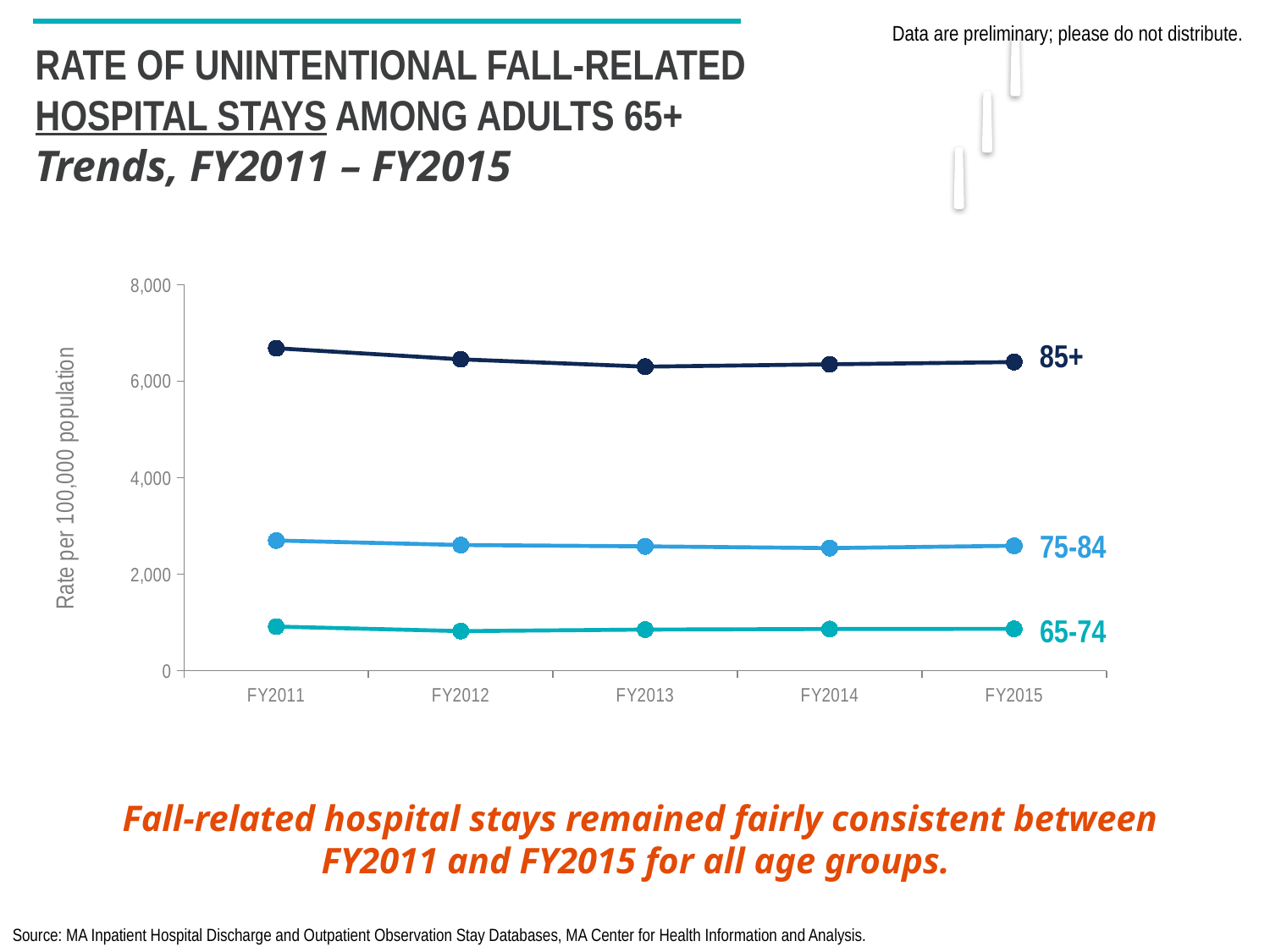
Is the rate for the 85+ group in FY2011 greater or less than 6,000? greater What is the label on the y axis of the chart? Rate per 100,000 population Is the rate for the 65-74 group in FY2013 greater or less than 2,000? less Is the rate for the 85+ group in FY2015 greater or less than 8,000? less In FY2014, which group has the larger rate: 75-84 or 65-74? 75-84 What kind of chart is shown on the slide? line chart How many fiscal years are shown along the x axis? 5 Which age group has the lowest rate of fall-related hospital stays in every year shown? 65-74 How many age-group series are plotted on the chart? 3 Did the rate for the 85+ group rise or fall between FY2011 and FY2013? fall Which age group has the highest rate of fall-related hospital stays in every year shown? 85+